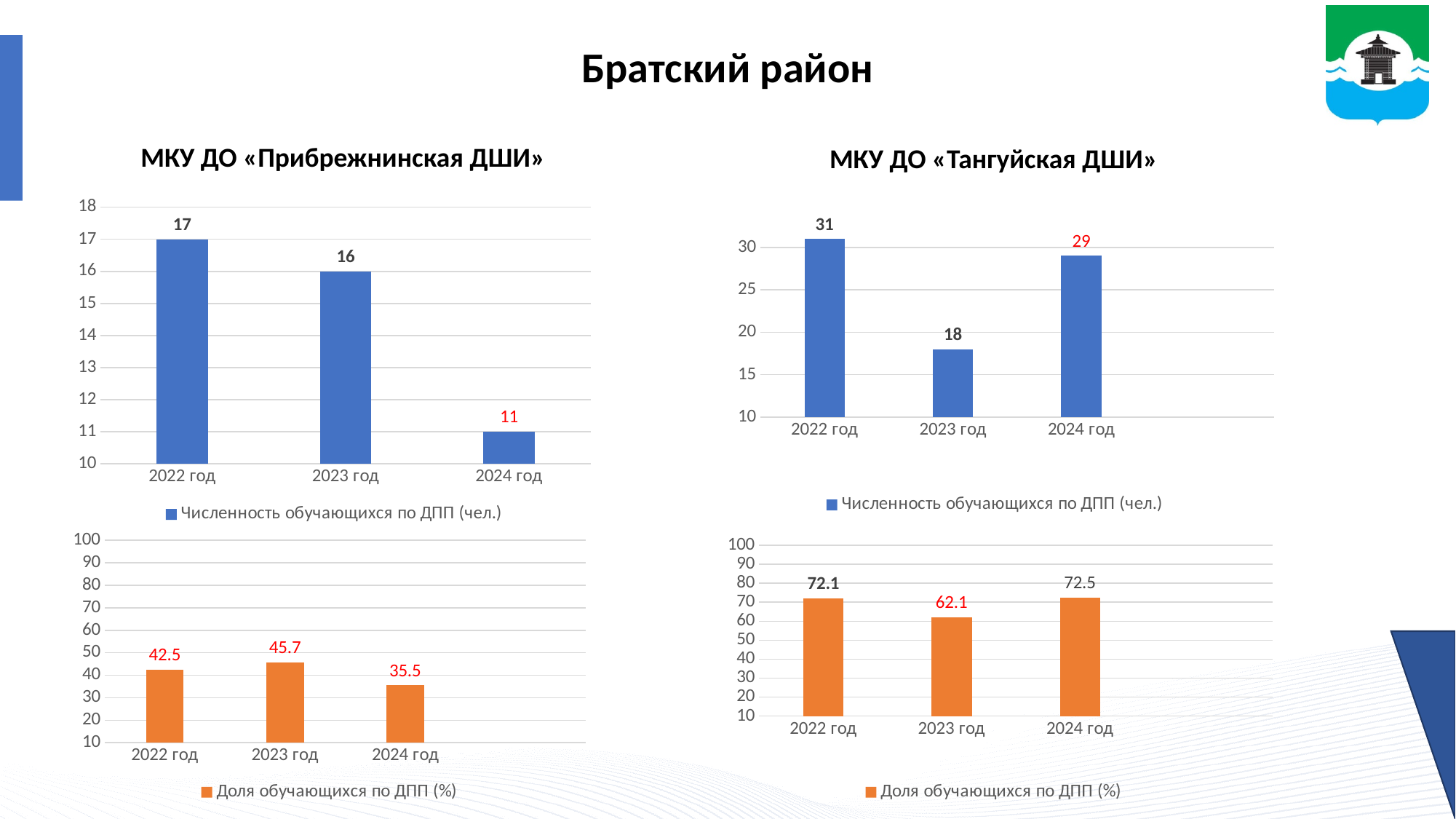
In the bottom-left chart (МКУ ДО «Прибрежнинская ДШИ», Доля обучающихся по ДПП), which year has the highest value? 2023 год How many charts are shown on the slide, and what type are they? 4 bar charts In the top-right chart (МКУ ДО «Тангуйская ДШИ», Численность обучающихся по ДПП), what is the value for 2023 год? 18 In the top-right chart (МКУ ДО «Тангуйская ДШИ», Численность обучающихся по ДПП), which is larger, 2022 год or 2024 год? 2022 год In the bottom-left chart (МКУ ДО «Прибрежнинская ДШИ», Доля обучающихся по ДПП), what is the value for 2023 год? 45.7 In the top-left chart (МКУ ДО «Прибрежнинская ДШИ», Численность обучающихся по ДПП), what is the value for 2022 год? 17 In the top-left chart (МКУ ДО «Прибрежнинская ДШИ», Численность обучающихся по ДПП), what is the difference between 2022 год and 2024 год? 6 In the bottom-right chart (МКУ ДО «Тангуйская ДШИ», Доля обучающихся по ДПП), what is the value for 2024 год? 72.5 In the top-left chart (МКУ ДО «Прибрежнинская ДШИ», Численность обучающихся по ДПП), do the values rise or fall from 2022 год to 2024 год? fall In the bottom-right chart (МКУ ДО «Тангуйская ДШИ», Доля обучающихся по ДПП), which year has the lowest value? 2023 год In the top-left chart (МКУ ДО «Прибрежнинская ДШИ», Численность обучающихся по ДПП), which year has the lowest value? 2024 год In the top-right chart (МКУ ДО «Тангуйская ДШИ», Численность обучающихся по ДПП), what is the difference between 2022 год and 2023 год? 13